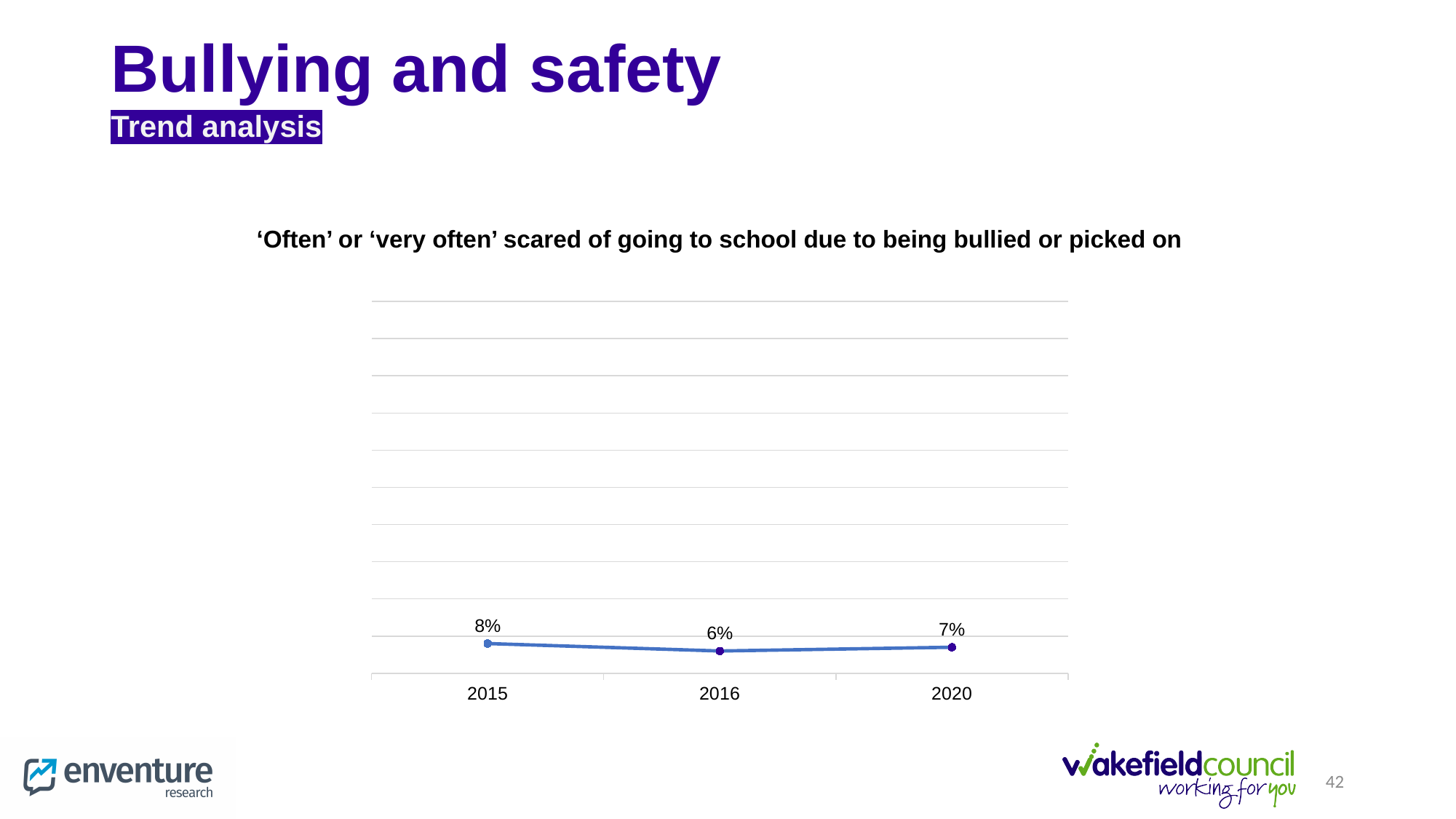
How many years are plotted on the chart? 3 What is the difference between the values for 2020 and 2016? 1% Does the value rise or fall from 2015 to 2016? Fall Which is larger, the value for 2015 or the value for 2020? 2015 Which year has the lowest value? 2016 What is the value for 2015? 8% What is the value for 2020? 7% What kind of chart is shown? Line chart What is the value for 2016? 6% Which year has the highest value? 2015 What is the difference between the values for 2015 and 2016? 2% What is the title of the chart? ‘Often’ or ‘very often’ scared of going to school due to being bullied or picked on